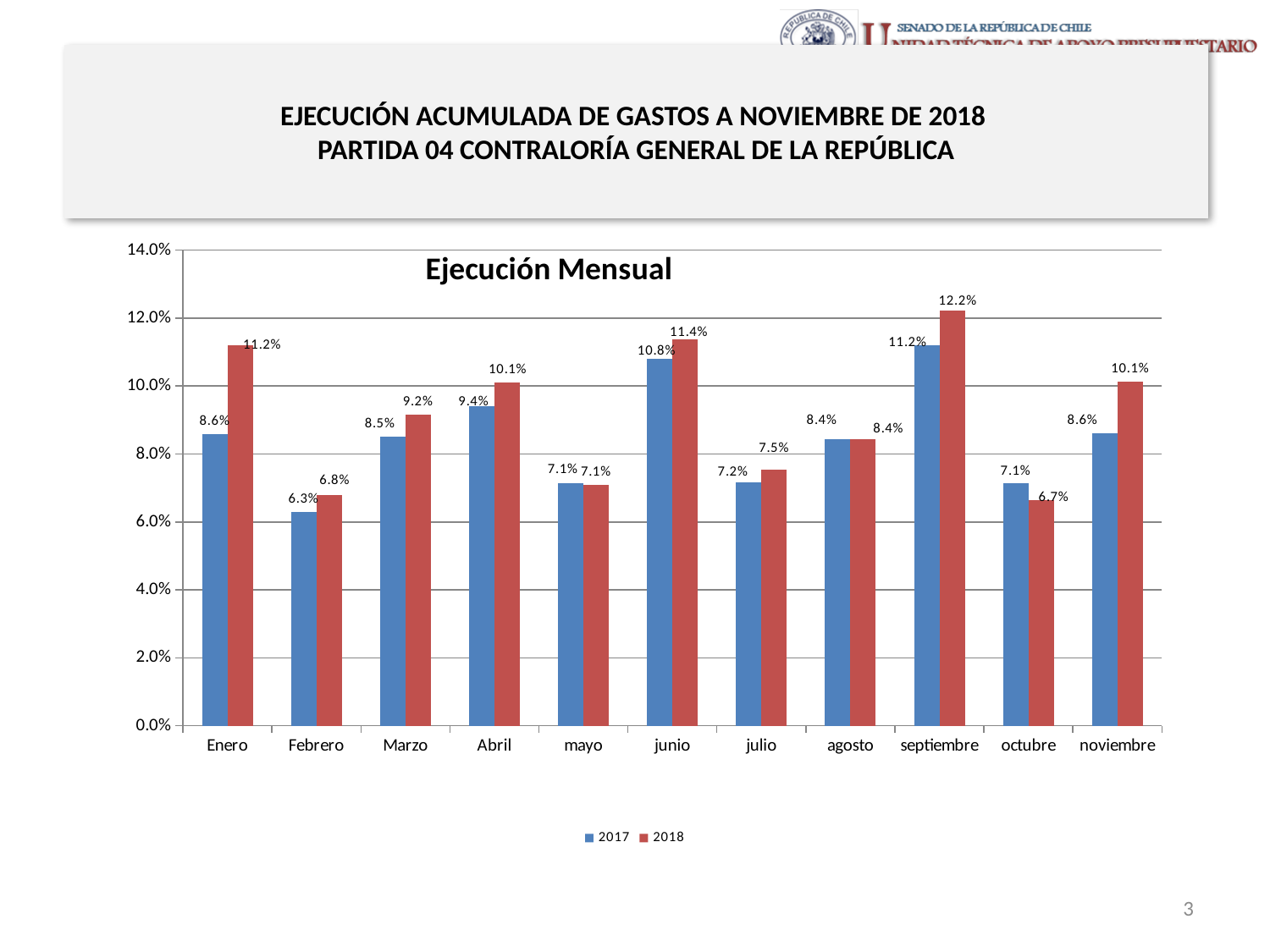
What kind of chart is shown on the slide? bar chart How many months are shown on the x axis? 11 In octubre, which series has the larger value, 2017 or 2018? 2017 What is the difference between the 2018 and 2017 values in Enero? 2.6 percentage points Is the 2017 value for junio greater or less than 10.0%? greater Which month has the lowest value for the 2017 series? Febrero How many series does the legend list? 2 What is the value for 2017 in Febrero? 6.3% Which month has the highest value for the 2018 series? septiembre What is the value for 2018 in septiembre? 12.2% What is the difference between the 2018 and 2017 values in septiembre? 1.0 percentage point What is the value for 2018 in noviembre? 10.1%